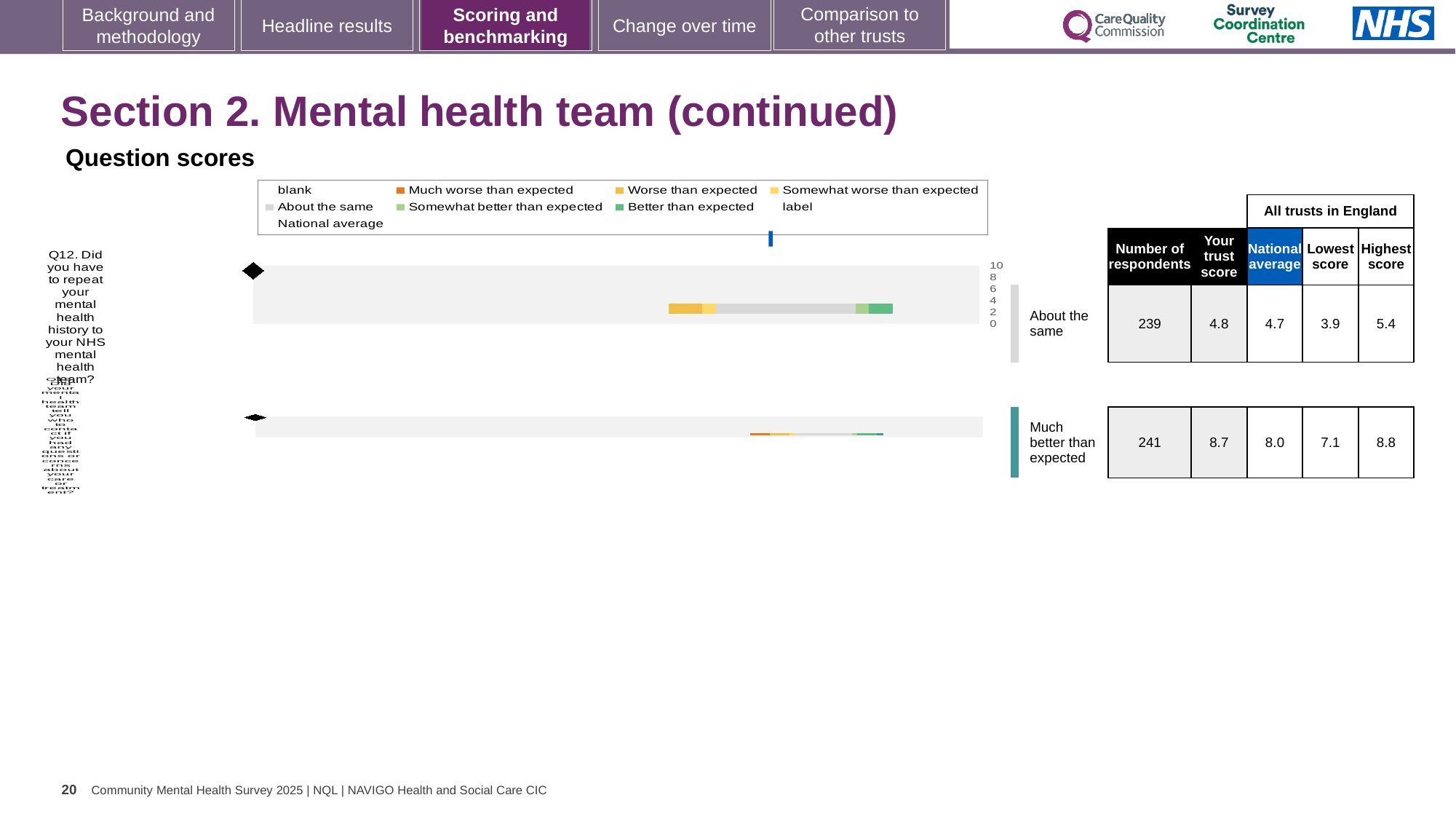
What is the benchmark rating shown for Q12 (repeating mental health history to the NHS mental health team)? About the same How many question rows are plotted in the question scores chart? 2 What is the difference between your trust score and the national average for the second question row (rated 'Much better than expected')? 0.7 What is the highest score among all trusts in England for Q12? 5.4 What is your trust score for Q12? 4.8 For Q12, which is larger: your trust score or the national average? Your trust score What is the national average for Q12? 4.7 What is the benchmark rating shown for the second question row in the chart? Much better than expected In the chart legend, what colour represents 'Much worse than expected'? Orange What is the number of respondents for Q12? 239 What kind of chart is used to show the question scores on this slide? bar chart What is the lowest score among all trusts in England for the second question row (rated 'Much better than expected')? 7.1